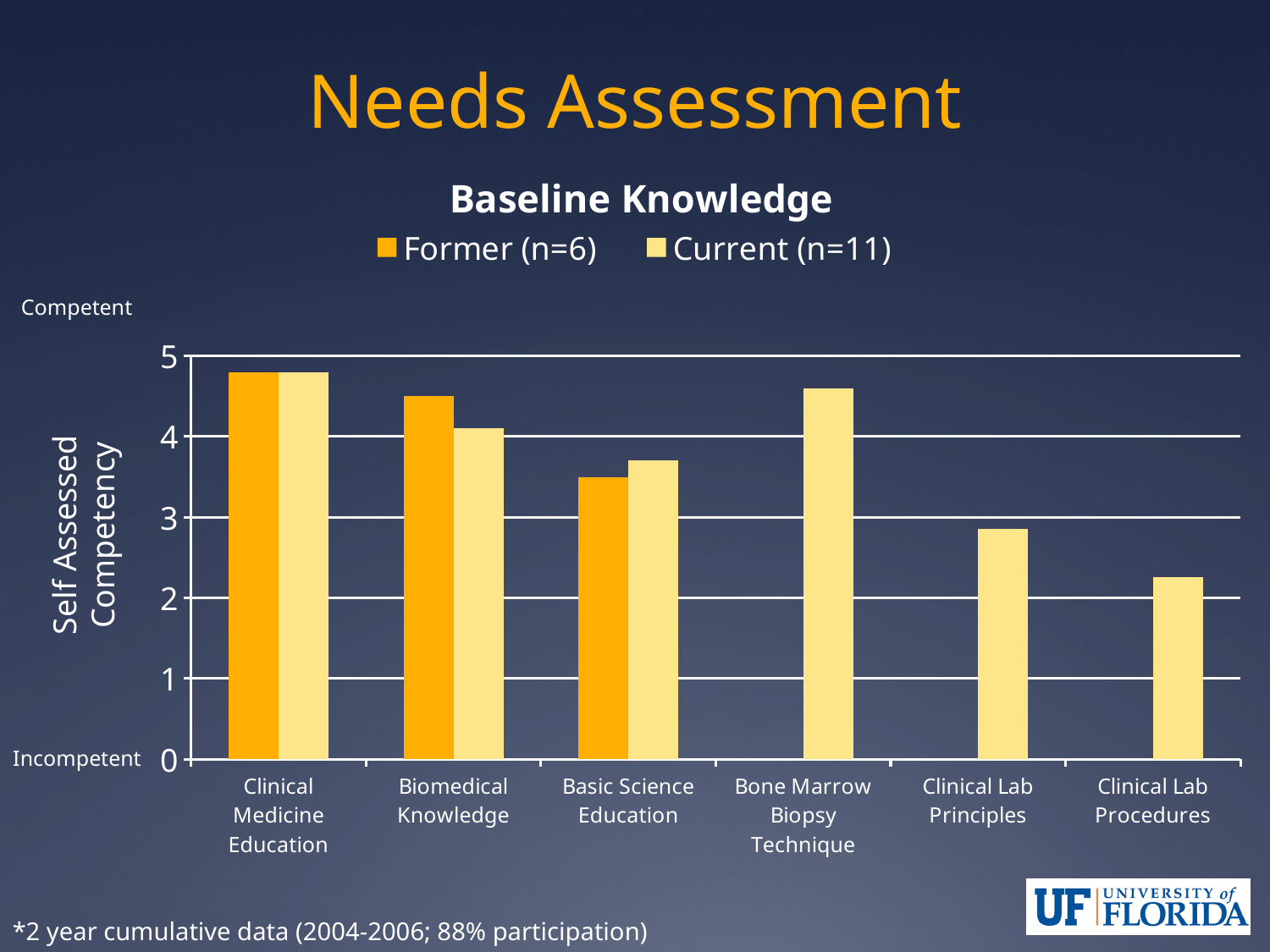
What is the label of the vertical axis? Self Assessed Competency Is the Current (n=11) value for Clinical Lab Principles greater or less than 3? less Which category has the highest value for the Former (n=6) series? Clinical Medicine Education How many categories are shown on the x axis? 6 Is the Current (n=11) value for Clinical Lab Procedures greater or less than 2? greater What is the title of the chart? Baseline Knowledge For Basic Science Education, which series has the larger value, Former (n=6) or Current (n=11)? Current (n=11) How many series does the legend list? 2 For Biomedical Knowledge, which series has the larger value, Former (n=6) or Current (n=11)? Former (n=6) Is the Current (n=11) value for Bone Marrow Biopsy Technique greater or less than 4? greater What kind of chart is shown on the slide? Bar chart Which category has the lowest value for the Current (n=11) series? Clinical Lab Procedures